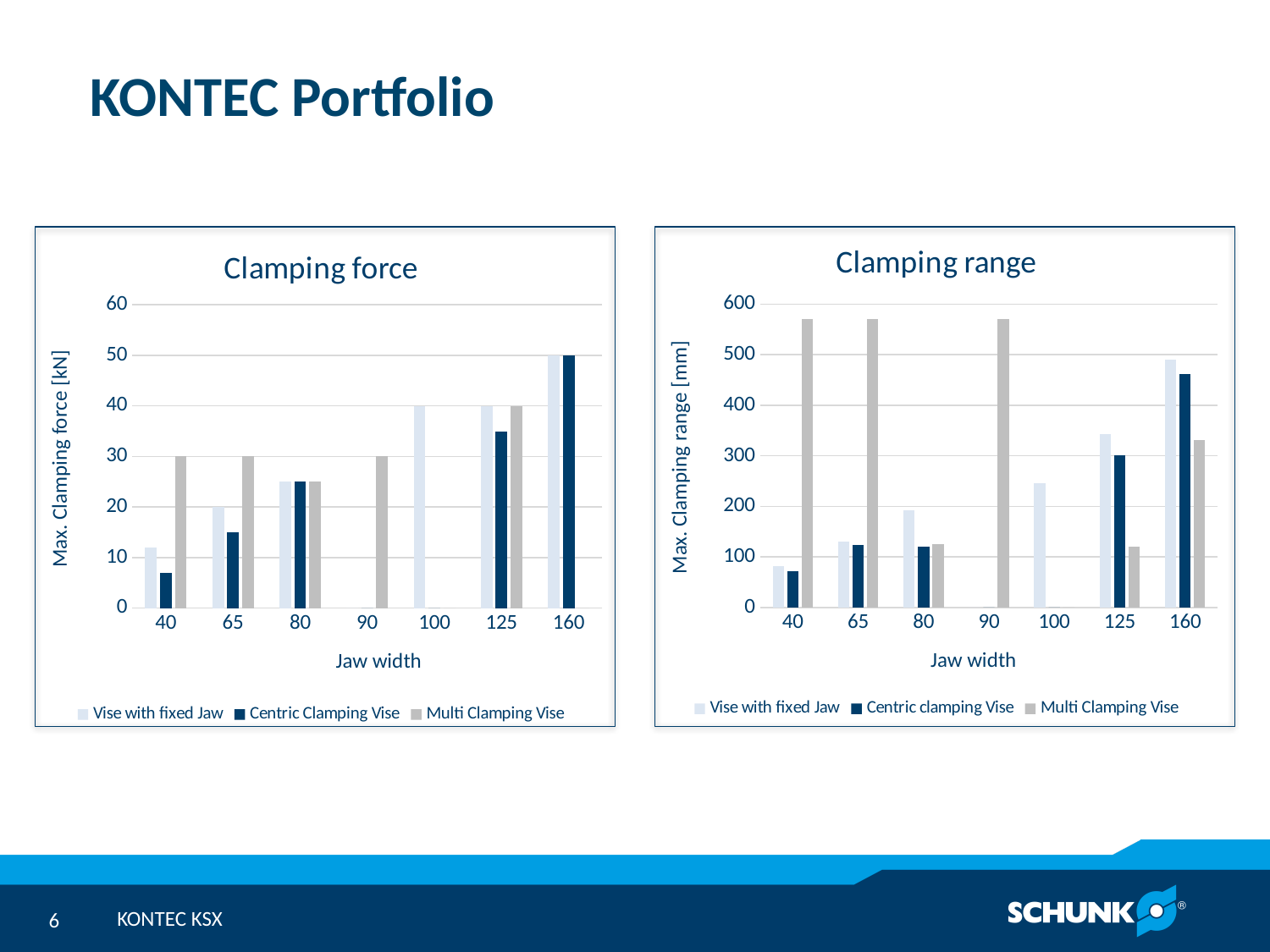
In the Clamping range chart, which is larger at jaw width 160: Vise with fixed Jaw or Multi Clamping Vise? Vise with fixed Jaw In the Clamping force chart, which jaw width has the highest Centric Clamping Vise value? 160 In the Clamping force chart, what is the value for Multi Clamping Vise at jaw width 40? 30 How many jaw width categories are shown on the x axis of the Clamping force chart? 7 How many series does the legend of the Clamping range chart list? 3 In the Clamping force chart, what is the difference between Vise with fixed Jaw at jaw width 160 and Vise with fixed Jaw at jaw width 65? 30 What type of chart is the Clamping force chart? bar chart What is the y-axis label of the Clamping range chart? Max. Clamping range [mm] In the Clamping range chart, is the value for Multi Clamping Vise at jaw width 90 greater or less than 500? greater In the Clamping force chart, what is the value for Vise with fixed Jaw at jaw width 100? 40 In the Clamping force chart, what is the value for Centric Clamping Vise at jaw width 160? 50